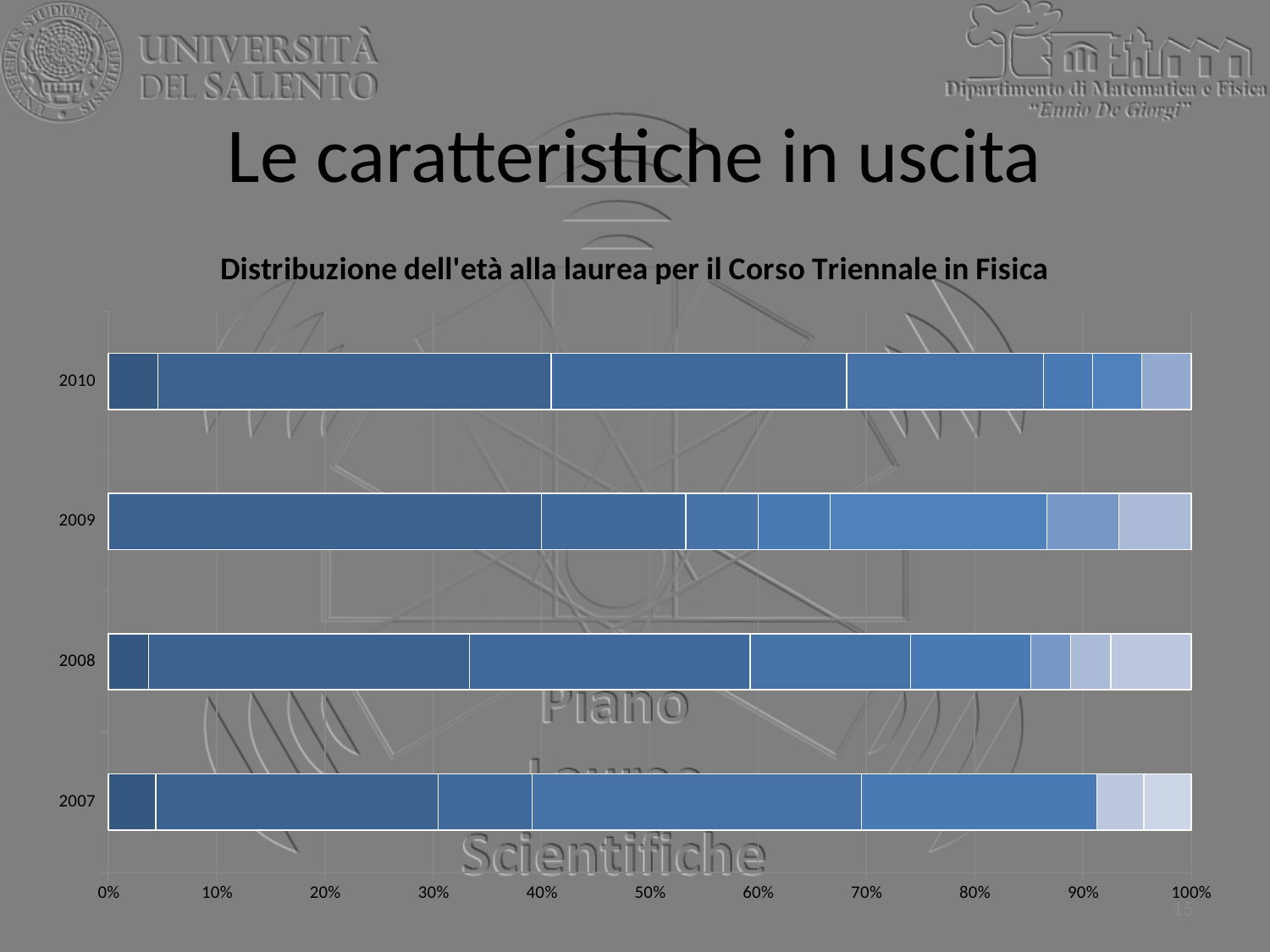
Which year's bar has the widest leftmost segment? 2009 Is the widest segment of the 2007 bar greater or less than 20% wide? greater Which year is shown at the bottom of the chart? 2007 What is the maximum value shown on the horizontal axis of the chart? 100% How many segments make up the 2008 bar? 8 Is the leftmost segment of the 2010 bar greater or less than 10% wide? less How many years (categories) are shown on the vertical axis of the chart? 4 Which year is shown at the top of the chart? 2010 What is the title of the chart? Distribuzione dell'età alla laurea per il Corso Triennale in Fisica What kind of chart is shown on the slide? bar chart Is the leftmost segment of the 2009 bar greater or less than 30% wide? greater